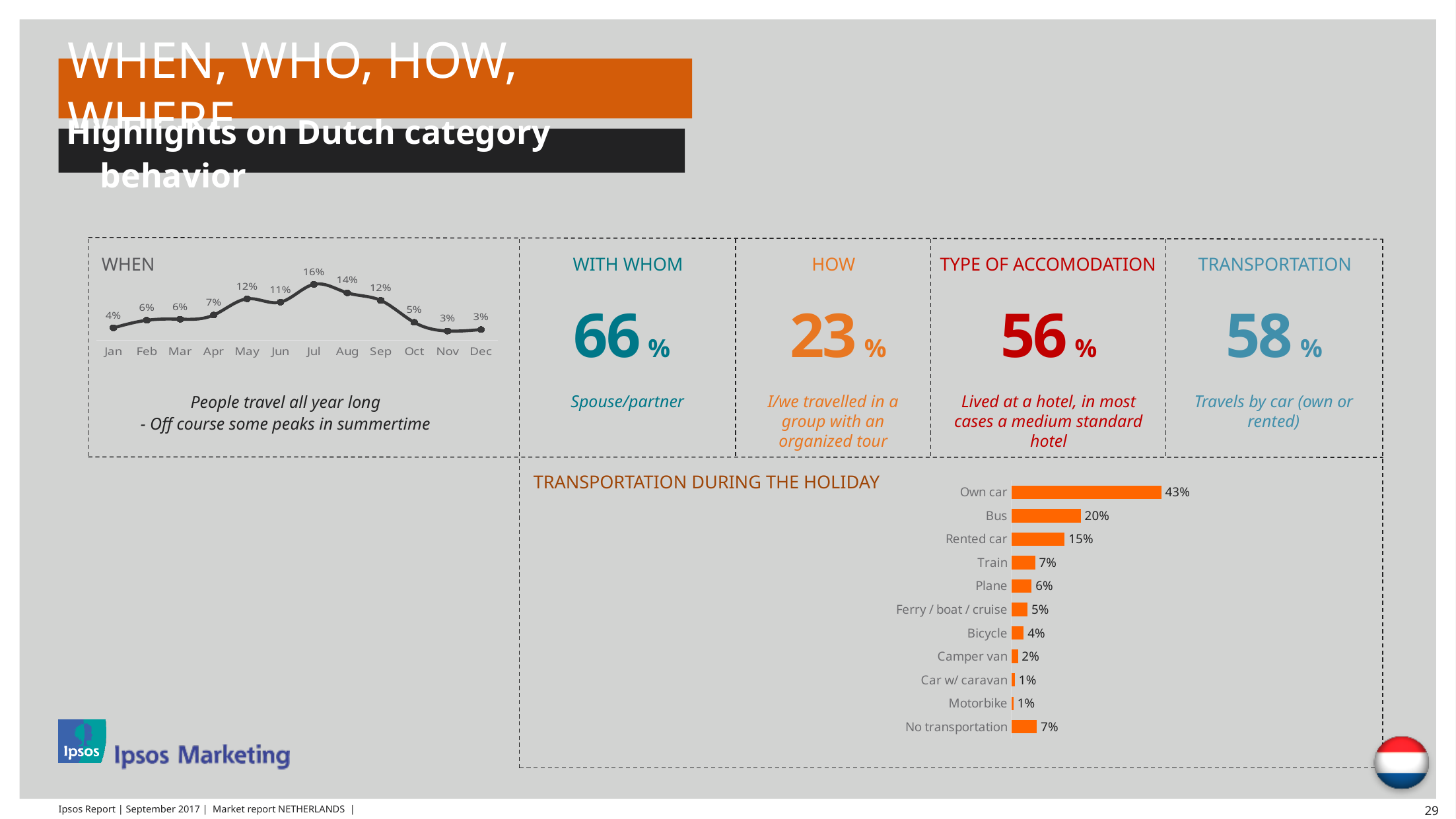
In the WHEN line chart, what is the value for Jul? 16% In the TRANSPORTATION DURING THE HOLIDAY chart, what is the value for Bus? 20% In the WHEN line chart, what is the difference between the values for Jul and Jan? 12% In the WHEN line chart, which month has the highest value? Jul In the TRANSPORTATION DURING THE HOLIDAY chart, which category has the highest value? Own car In the WHEN line chart, do the values rise or fall from Sep to Dec? fall In the WHEN line chart, how many months are plotted? 12 In the TRANSPORTATION DURING THE HOLIDAY chart, how many categories are shown? 11 In the TRANSPORTATION DURING THE HOLIDAY chart, what is the difference between Own car and Rented car? 28% What kind of chart is the TRANSPORTATION DURING THE HOLIDAY chart? bar chart In the WHEN line chart, what is the value for Jan? 4% In the TRANSPORTATION DURING THE HOLIDAY chart, which is larger, Train or Plane? Train